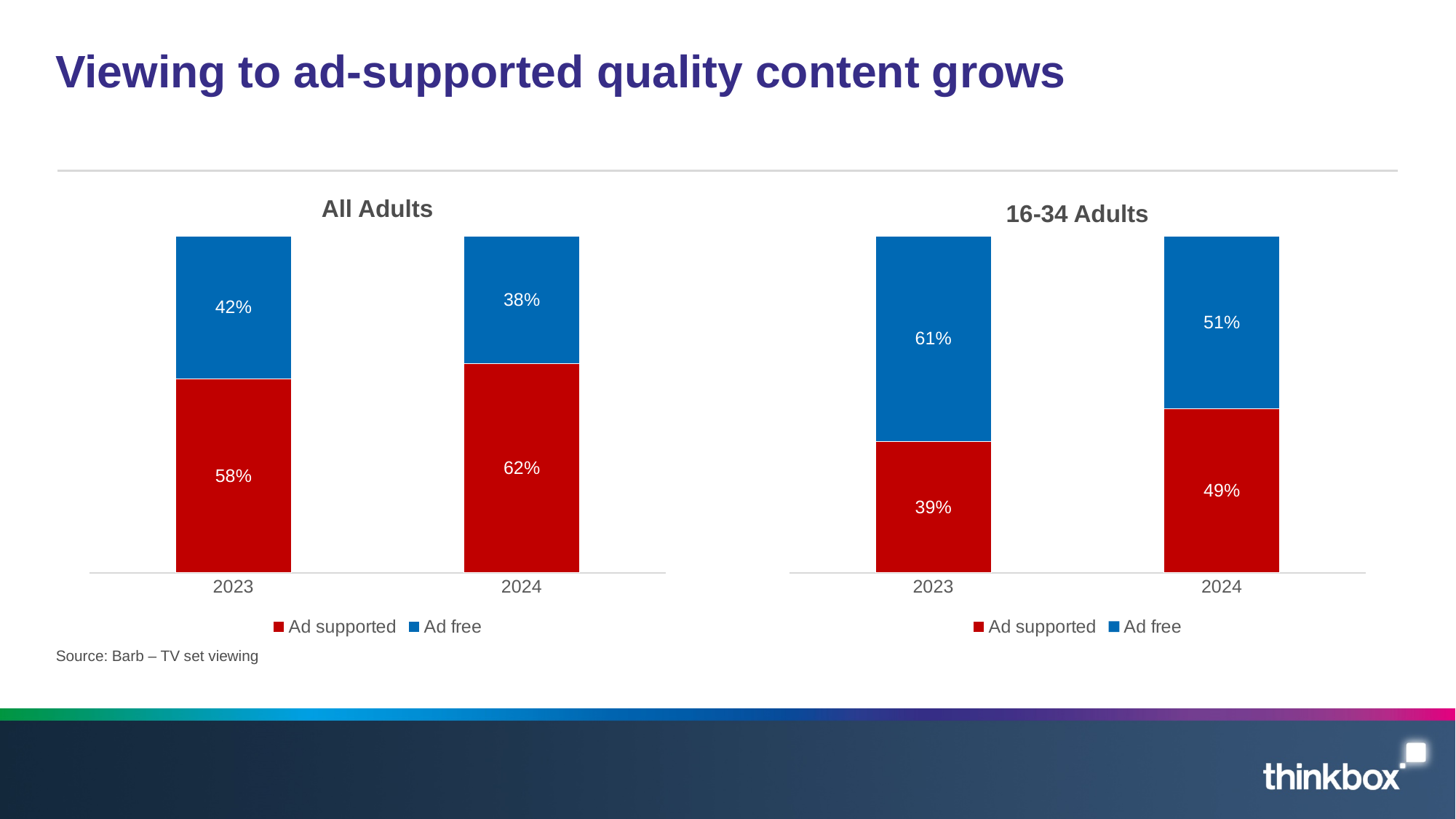
In the All Adults chart, what is the total of the 2024 stacked bar? 100% How many series does the legend of the All Adults chart list? 2 In the All Adults chart, does the Ad supported share rise or fall from 2023 to 2024? Rise In the 16-34 Adults chart, what is the Ad free value for 2023? 61% In the All Adults chart, what is the Ad supported value for 2023? 58% In the 16-34 Adults chart, what is the difference between the Ad free and Ad supported values in 2023? 22 percentage points In the 16-34 Adults chart, does the Ad free share rise or fall from 2023 to 2024? Fall In the 16-34 Adults chart, what is the Ad supported value for 2024? 49% In the All Adults chart, what is the Ad free value for 2024? 38% In the All Adults chart, by how many percentage points did the Ad supported share change from 2023 to 2024? 4 percentage points What type of chart is the 16-34 Adults chart? Stacked bar chart In the 16-34 Adults chart, which is larger in 2024, Ad supported or Ad free? Ad free